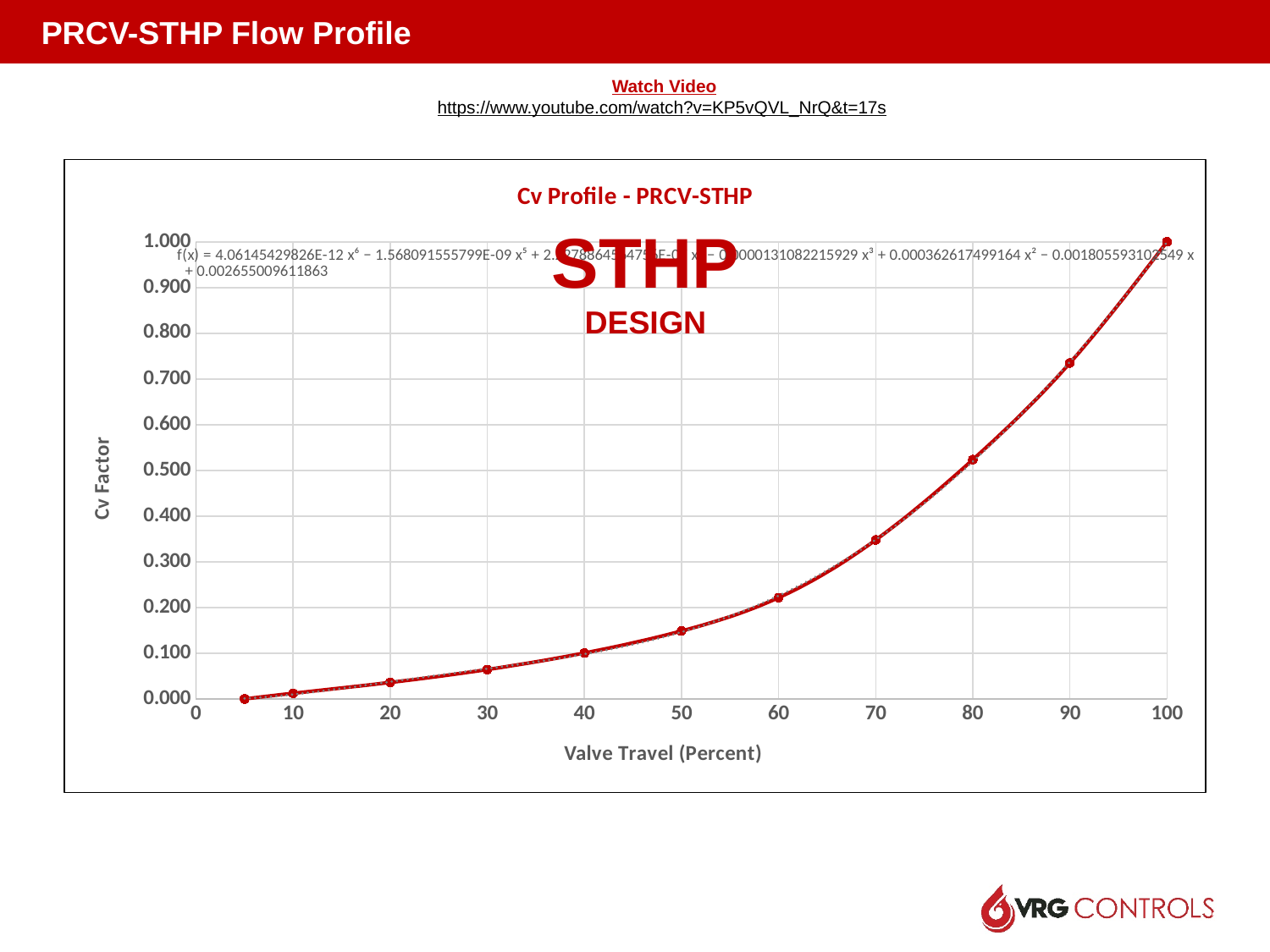
What kind of chart is shown on the slide? line chart What is the Cv Factor at 100 percent Valve Travel? 1.000 What is the title of the chart? Cv Profile - PRCV-STHP How many data points are plotted on the chart? 11 Is the Cv Factor at 70 percent Valve Travel greater or less than 0.300? greater At which Valve Travel percentage is the Cv Factor highest? 100 Does the Cv Factor rise or fall as Valve Travel increases from 0 to 100 percent? rise Which has a larger Cv Factor: 60 percent or 80 percent Valve Travel? 80 percent What is the label of the x axis? Valve Travel (Percent) Is the Cv Factor at 90 percent Valve Travel greater or less than 0.800? less